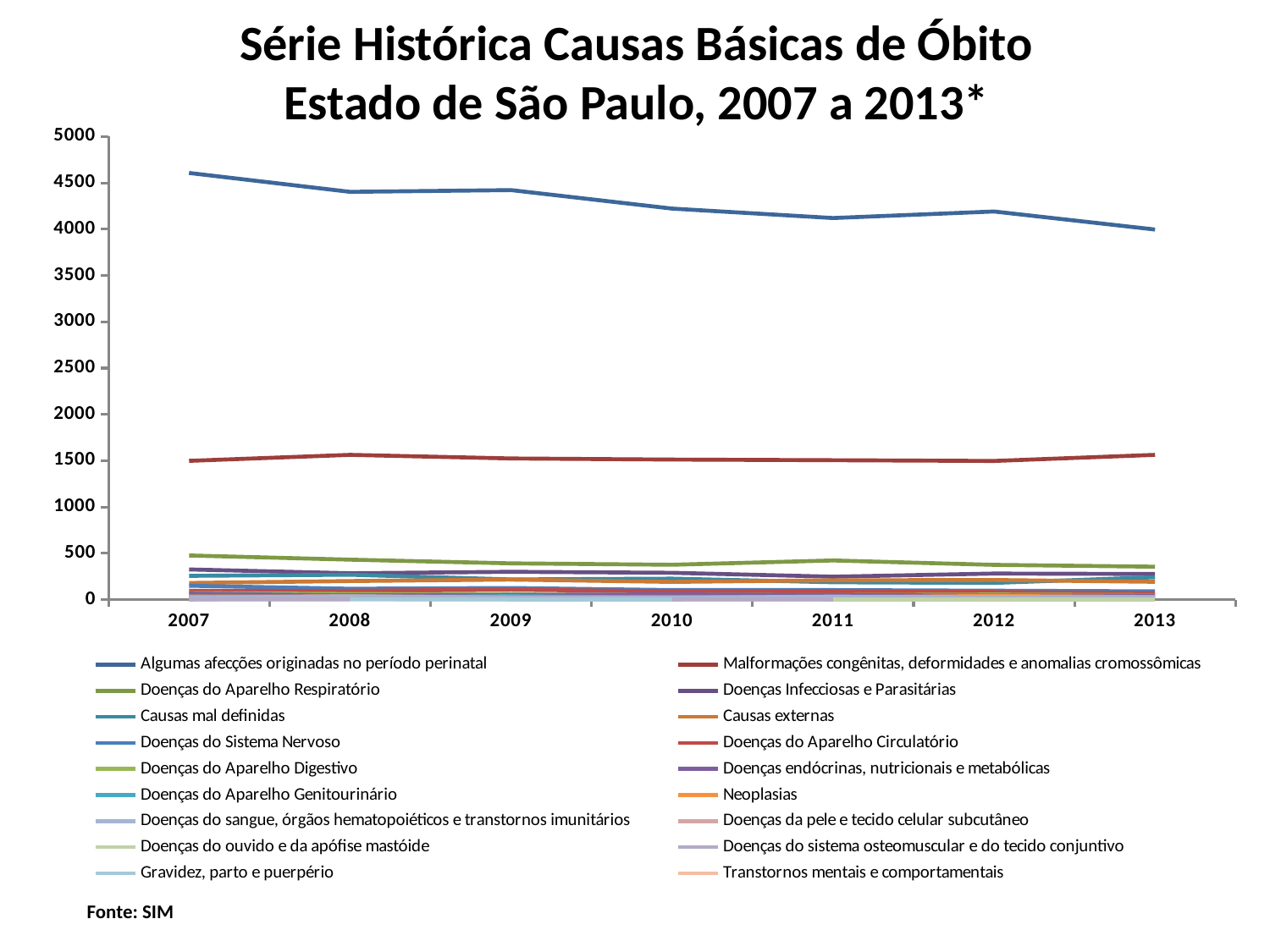
Is the value for Algumas afecções originadas no período perinatal in 2011 greater or less than 4000? greater What source is cited below the chart? SIM What is the title of the chart? Série Histórica Causas Básicas de Óbito Estado de São Paulo, 2007 a 2013* Does the line for Algumas afecções originadas no período perinatal rise or fall overall from 2007 to 2013? fall Is the value for Algumas afecções originadas no período perinatal in 2007 greater or less than 4500? greater In which year does Algumas afecções originadas no período perinatal reach its highest value? 2007 How many series does the legend list? 18 What kind of chart is shown on the slide? line chart How many years are plotted along the x axis? 7 Which series has the highest values across all years? Algumas afecções originadas no período perinatal For Algumas afecções originadas no período perinatal, which year has the larger value, 2007 or 2013? 2007 Is the value for Algumas afecções originadas no período perinatal in 2008 greater or less than 4500? less